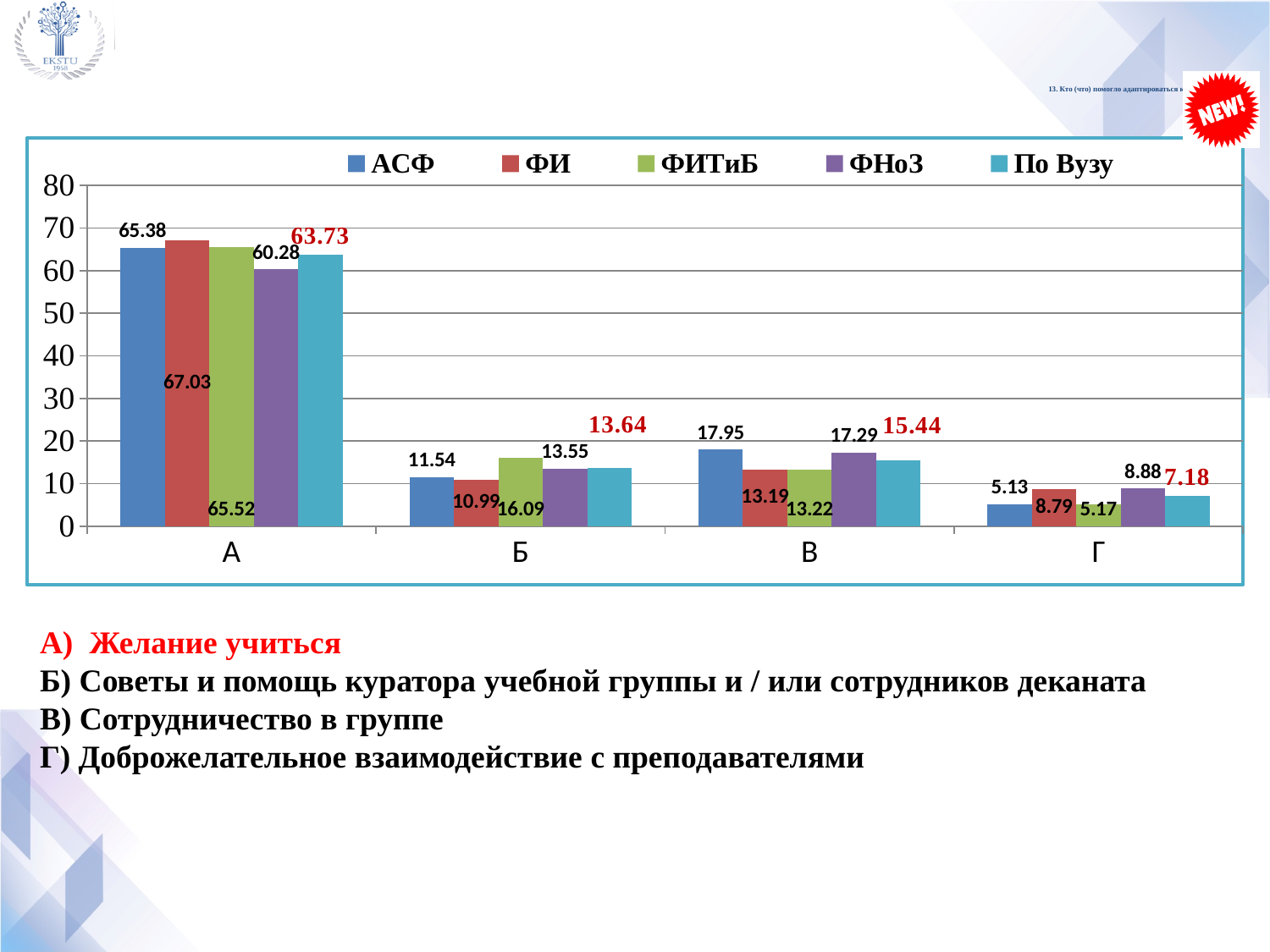
What is the value for ФНоЗ in category Г? 8.88 Which series has the lowest value in category Г? АСФ What is the value for ФИТиБ in category В? 13.22 Which series has the highest value in category А? ФИ Is the value for ФНоЗ in category А greater or less than 50? greater What is the difference between the АСФ and ФИ values in category В? 4.76 How many series does the legend list? 5 What kind of chart is shown on the slide? Bar chart How many categories are shown on the x axis? 4 What is the value for АСФ in category А? 65.38 What is the value for По Вузу in category Б? 13.64 In category Б, which is larger: the value for ФИТиБ or the value for ФНоЗ? ФИТиБ